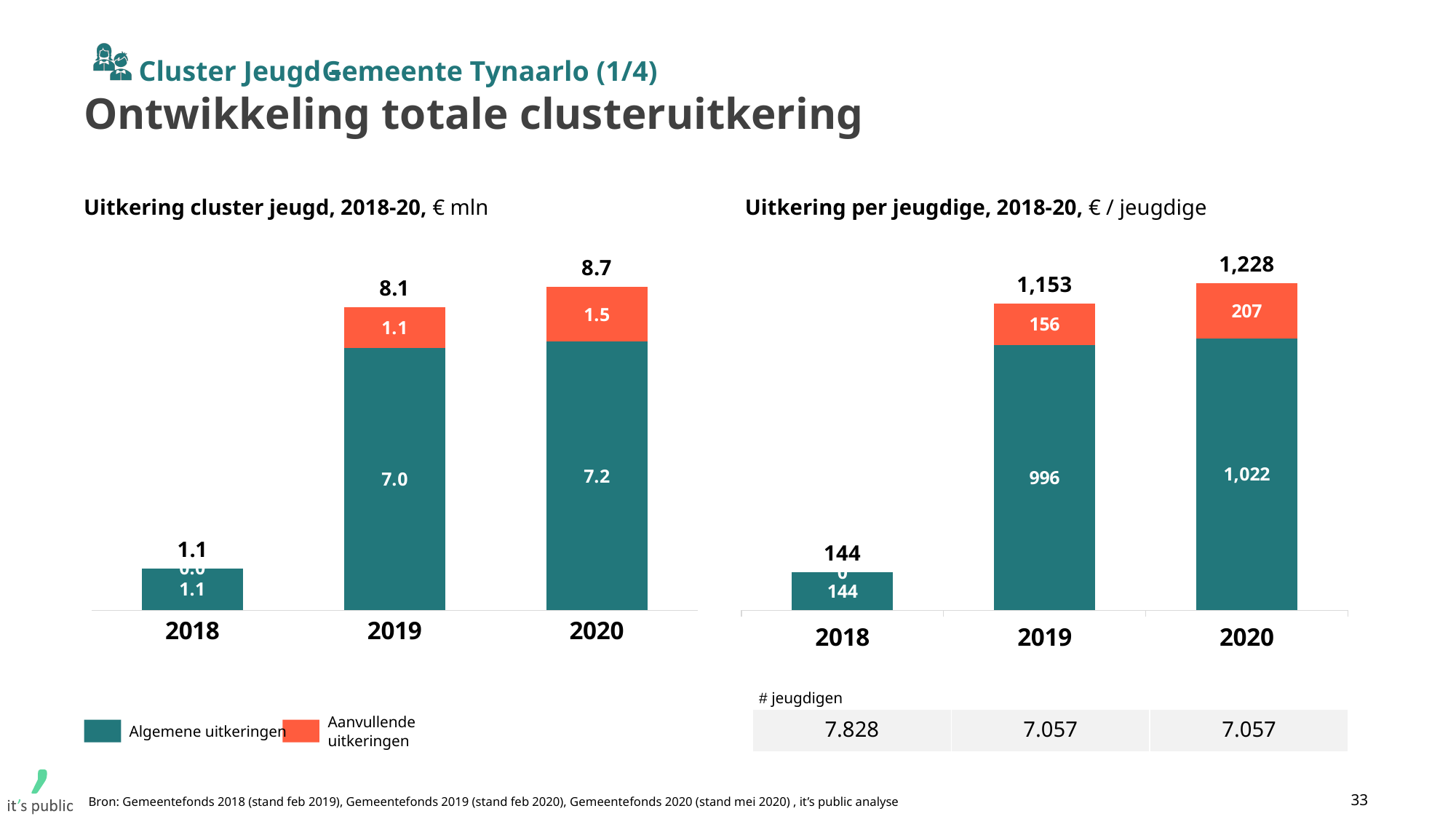
In the chart 'Uitkering per jeugdige, 2018-20', what is the value of Aanvullende uitkeringen for 2019? 156 In the chart 'Uitkering per jeugdige, 2018-20', what is the value of Algemene uitkeringen for 2020? 1,022 In the chart 'Uitkering cluster jeugd, 2018-20', what is the difference between the total for 2020 and the total for 2019? 0.6 In the chart 'Uitkering cluster jeugd, 2018-20', which year has the lowest total uitkering? 2018 In the chart 'Uitkering cluster jeugd, 2018-20', what is the total of the stacked bar for 2020? 8.7 How many series does the legend list for the chart 'Uitkering cluster jeugd, 2018-20'? 2 In the chart 'Uitkering cluster jeugd, 2018-20', what is the value of Aanvullende uitkeringen for 2020? 1.5 In the chart 'Uitkering cluster jeugd, 2018-20', what is the value of Algemene uitkeringen for 2019? 7.0 How many years are shown on the x axis of the chart 'Uitkering cluster jeugd, 2018-20'? 3 In the chart 'Uitkering per jeugdige, 2018-20', is the Aanvullende uitkeringen value larger in 2019 or in 2020? 2020 In the chart 'Uitkering per jeugdige, 2018-20', what is the total labelled above the 2020 bar? 1,228 In the chart 'Uitkering per jeugdige, 2018-20', which year has the highest uitkering per jeugdige? 2020